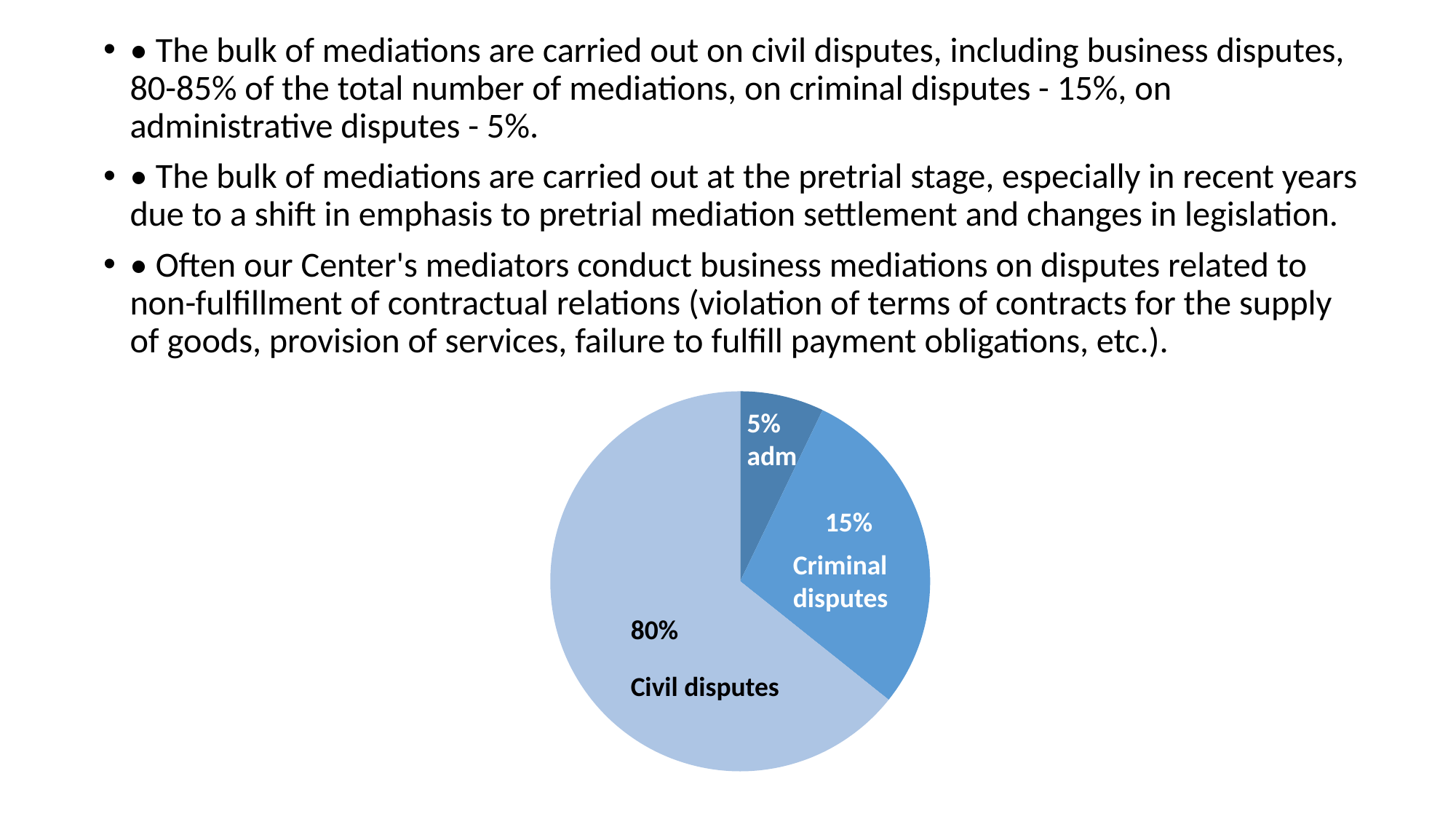
How many slices does the pie chart have? 3 What kind of chart is shown on the slide? pie chart What share of the pie is Civil disputes? 80% What share of the pie is Criminal disputes? 15% Which slice of the pie is the largest? Civil disputes Which slice of the pie is the darkest blue? adm Which is larger, the Criminal disputes slice or the adm slice? Criminal disputes Is the Civil disputes share greater or less than 50%? greater What is the difference between the Criminal disputes share and the adm share? 10% Which slice of the pie is the smallest? adm What share of the pie is adm? 5% What is the difference between the Civil disputes share and the Criminal disputes share? 65%